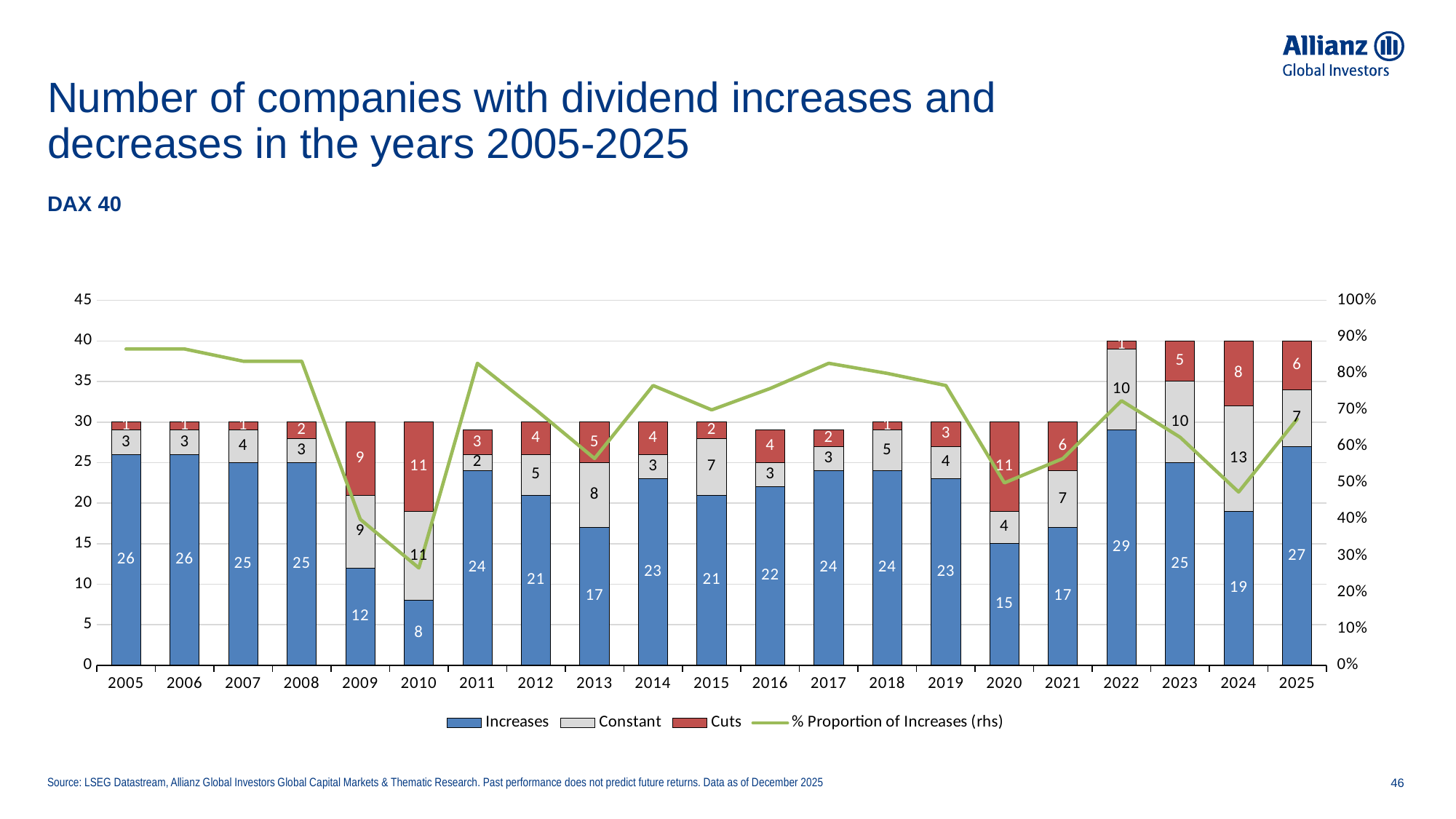
How many series does the legend list? 4 What is the value of the Cuts series for 2020? 11 How many years are shown on the x axis? 21 What is the difference between the number of increases in 2022 and in 2024? 10 Which year has the lowest number of dividend increases? 2010 Is the % Proportion of Increases for 2010 greater or less than 30%? less What is the total height of the stacked bar for 2025? 40 What is the value of the Constant series for 2024? 13 Which year has the highest number of dividend increases? 2022 How many companies had dividend increases in 2022? 29 Which series is plotted on the right-hand axis? % Proportion of Increases (rhs) Which is larger, the number of cuts in 2009 or in 2013? 2009